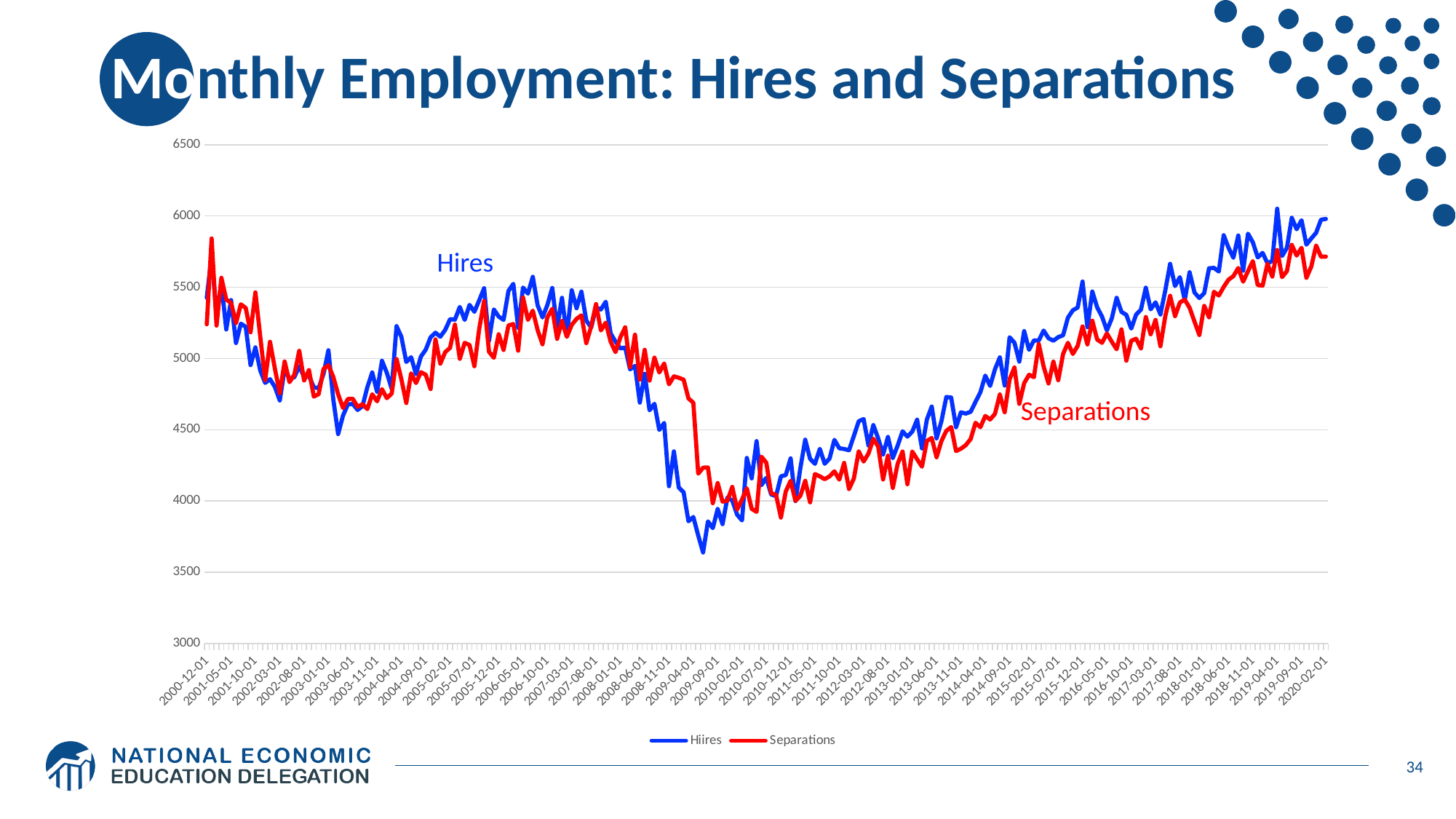
How many series does the legend list? 2 Do Separations rise or fall between 2011-05-01 and 2019-04-01? rise What colour is the Hires line? blue What are the two series shown in the chart? Hires and Separations Which series is higher at 2009-04-01, Hires or Separations? Separations Is the value for Separations at 2010-02-01 greater or less than 4500? less Which series reaches the highest value anywhere on the chart? Hires Is the value for Hires at 2003-06-01 greater or less than 5000? less What kind of chart is shown on the slide? line chart Is the value for Hires at 2019-04-01 greater or less than 5500? greater Do Hires rise or fall between 2008-06-01 and 2009-04-01? fall